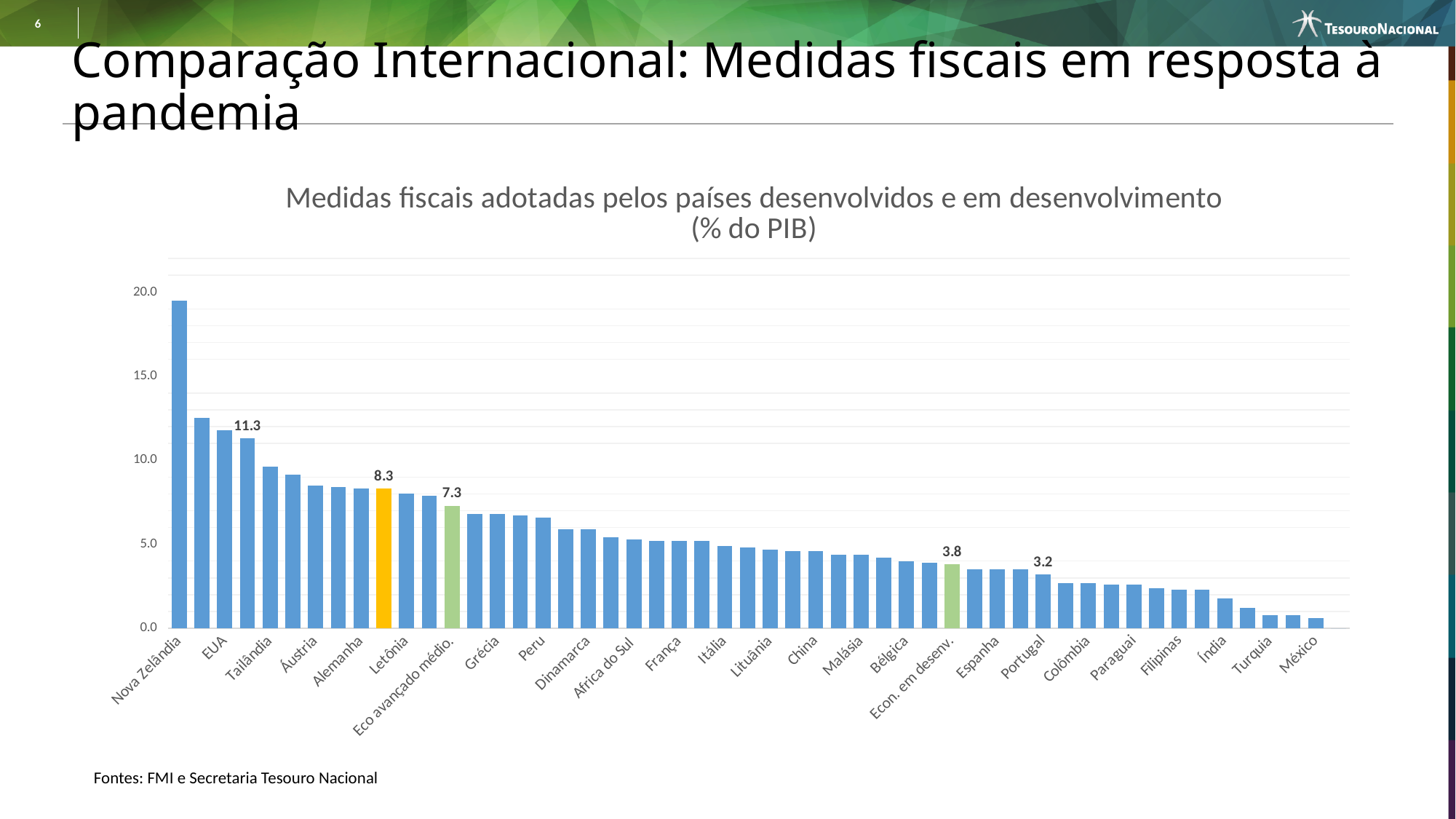
What kind of chart is shown on the slide? bar chart What value is printed on the orange highlighted bar? 8.3 Which is larger, the value for Eco avançado médio. or the value for Econ. em desenv.? Eco avançado médio. Which labelled category has the lowest value in the chart? México Do the values rise or fall moving from left to right along the x axis? fall What is the value shown for Econ. em desenv.? 3.8 Which category has the highest value in the chart? Nova Zelândia What is the difference between the values for Eco avançado médio. and Econ. em desenv.? 3.5 What is the value shown for the green bar labelled Eco avançado médio.? 7.3 Is the value for Índia greater or less than 5.0? less What is the title of the chart? Medidas fiscais adotadas pelos países desenvolvidos e em desenvolvimento (% do PIB) Is the value for Nova Zelândia greater or less than 15.0? greater